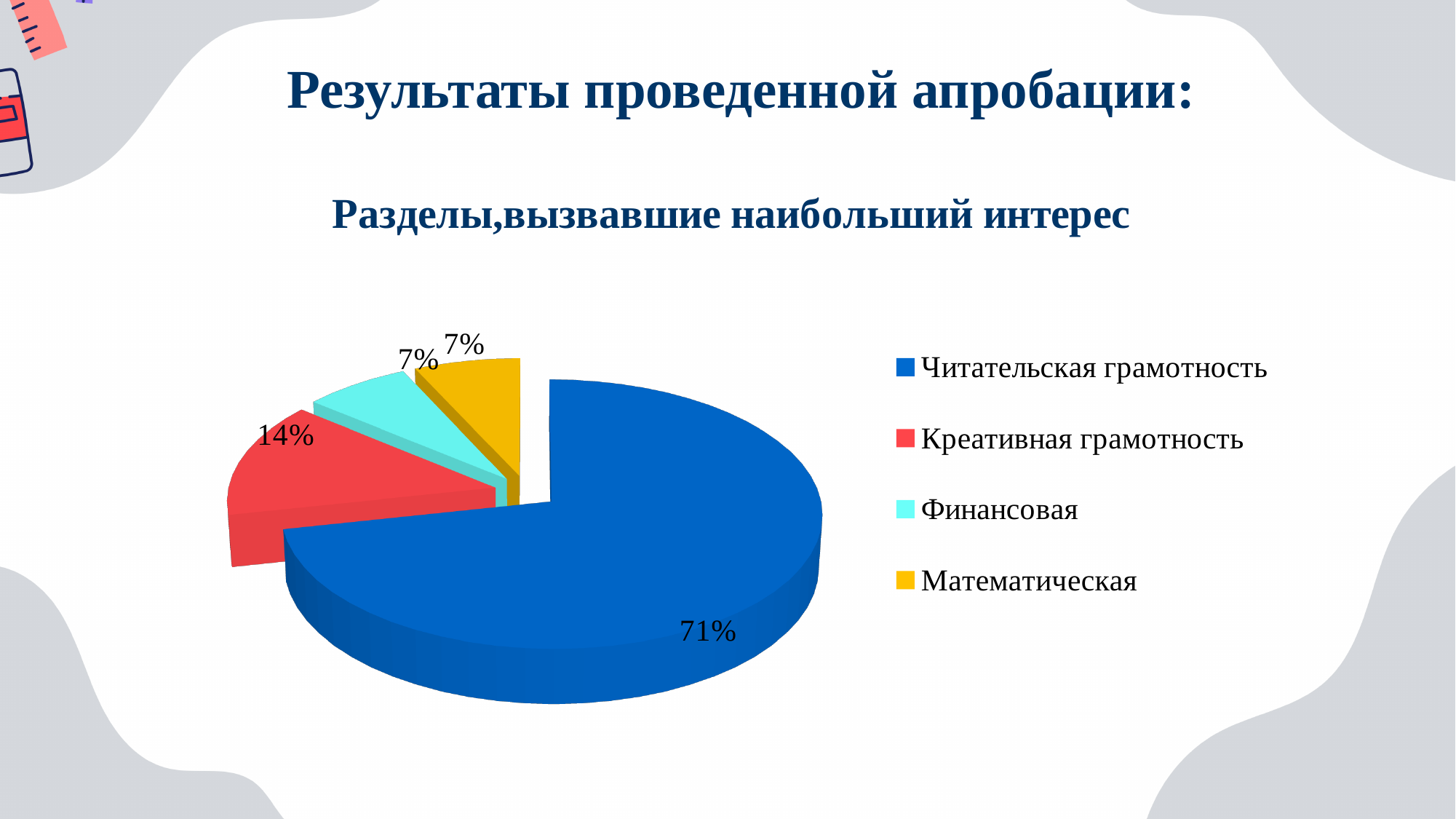
What kind of chart is shown on the slide? pie chart Which is larger, the value for Креативная грамотность or the value for Математическая? Креативная грамотность What share of the pie does Читательская грамотность have? 71% How many categories does the legend list? 4 What is the value for Математическая? 7% What colour is the slice for Математическая? yellow Which category has the largest slice of the pie? Читательская грамотность What is the value for Финансовая? 7% What is the difference between the values for Читательская грамотность and Креативная грамотность? 57% What is the title of the chart? Разделы,вызвавшие наибольший интерес What is the difference between the values for Креативная грамотность and Финансовая? 7% What is the value for Креативная грамотность? 14%